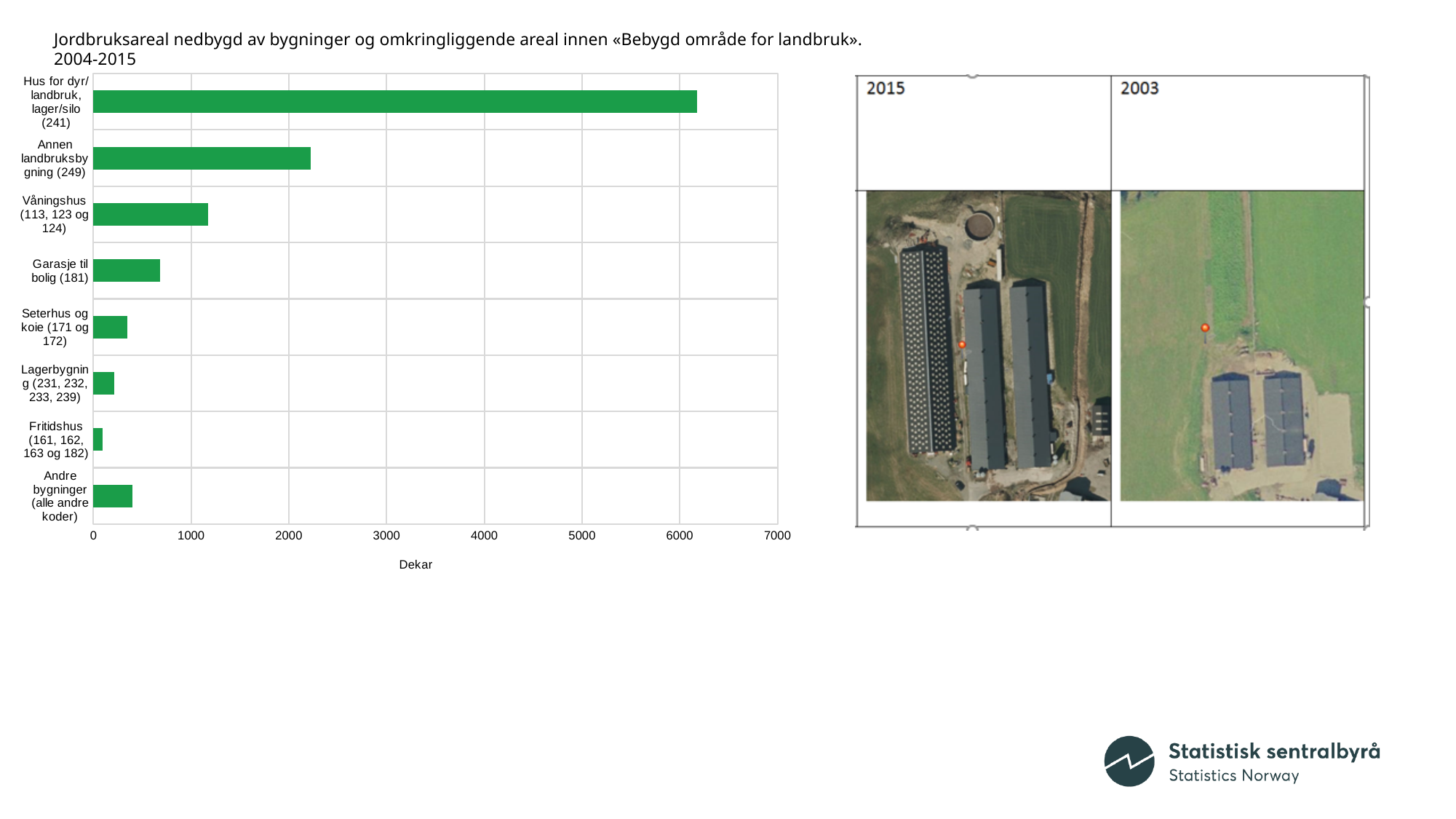
Is the value for Garasje til bolig (181) greater or less than 1000? less Which is larger, the value for Garasje til bolig (181) or the value for Seterhus og koie (171 og 172)? Garasje til bolig (181) Which category has the largest area in the bar chart? Hus for dyr/landbruk, lager/silo (241) Which is larger, the value for Annen landbruksbygning (249) or the value for Våningshus (113, 123 og 124)? Annen landbruksbygning (249) Which is larger, the value for Andre bygninger (alle andre koder) or the value for Lagerbygning (231, 232, 233, 239)? Andre bygninger (alle andre koder) Which category has the smallest area in the bar chart? Fritidshus (161, 162, 163 og 182) Is the value for Våningshus (113, 123 og 124) greater or less than 1000? greater How many building categories are shown in the bar chart? 8 Is the value for Annen landbruksbygning (249) greater or less than 2000? greater What kind of chart is shown on the slide? bar chart What unit is shown on the horizontal axis of the bar chart? Dekar